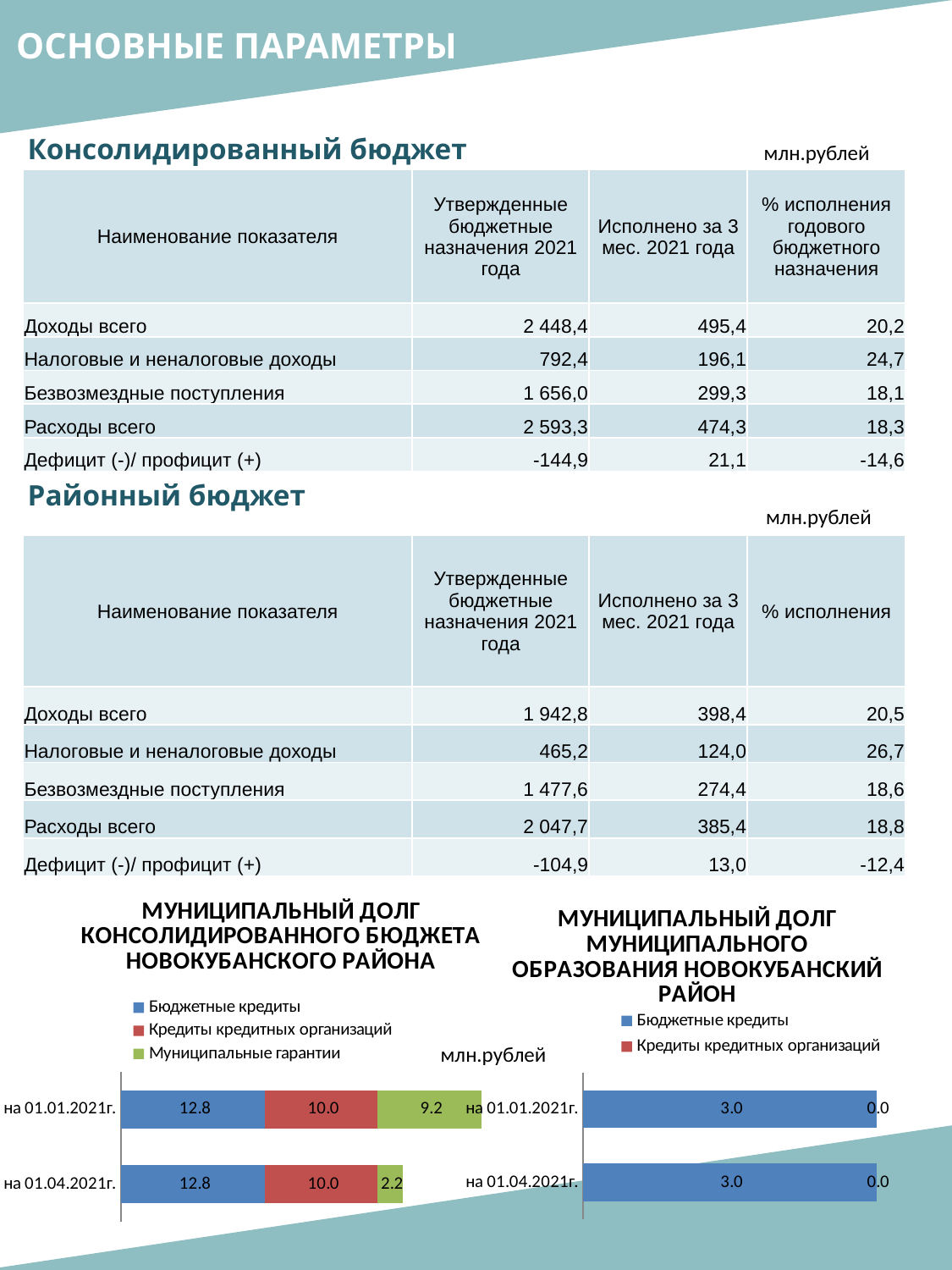
In the chart titled 'МУНИЦИПАЛЬНЫЙ ДОЛГ КОНСОЛИДИРОВАННОГО БЮДЖЕТА НОВОКУБАНСКОГО РАЙОНА', by how much did 'Муниципальные гарантии' decrease from 'на 01.01.2021г.' to 'на 01.04.2021г.'? 7.0 In the chart titled 'МУНИЦИПАЛЬНЫЙ ДОЛГ КОНСОЛИДИРОВАННОГО БЮДЖЕТА НОВОКУБАНСКОГО РАЙОНА', what is the value of 'Кредиты кредитных организаций' for 'на 01.01.2021г.'? 10.0 In the chart titled 'МУНИЦИПАЛЬНЫЙ ДОЛГ КОНСОЛИДИРОВАННОГО БЮДЖЕТА НОВОКУБАНСКОГО РАЙОНА', what is the value of 'Муниципальные гарантии' for 'на 01.01.2021г.'? 9.2 In the chart titled 'МУНИЦИПАЛЬНЫЙ ДОЛГ КОНСОЛИДИРОВАННОГО БЮДЖЕТА НОВОКУБАНСКОГО РАЙОНА', what is the value of 'Муниципальные гарантии' for 'на 01.04.2021г.'? 2.2 What type of chart is the one titled 'МУНИЦИПАЛЬНЫЙ ДОЛГ МУНИЦИПАЛЬНОГО ОБРАЗОВАНИЯ НОВОКУБАНСКИЙ РАЙОН'? Bar chart In the chart titled 'МУНИЦИПАЛЬНЫЙ ДОЛГ КОНСОЛИДИРОВАННОГО БЮДЖЕТА НОВОКУБАНСКОГО РАЙОНА', how many series does the legend list? 3 In the chart titled 'МУНИЦИПАЛЬНЫЙ ДОЛГ КОНСОЛИДИРОВАННОГО БЮДЖЕТА НОВОКУБАНСКОГО РАЙОНА', what is the value of 'Бюджетные кредиты' for 'на 01.04.2021г.'? 12.8 In the chart titled 'МУНИЦИПАЛЬНЫЙ ДОЛГ КОНСОЛИДИРОВАННОГО БЮДЖЕТА НОВОКУБАНСКОГО РАЙОНА', what is the total of the stacked bar for 'на 01.01.2021г.'? 32.0 In the chart titled 'МУНИЦИПАЛЬНЫЙ ДОЛГ КОНСОЛИДИРОВАННОГО БЮДЖЕТА НОВОКУБАНСКОГО РАЙОНА', which series is larger for 'на 01.04.2021г.': 'Бюджетные кредиты' or 'Муниципальные гарантии'? Бюджетные кредиты In the chart titled 'МУНИЦИПАЛЬНЫЙ ДОЛГ КОНСОЛИДИРОВАННОГО БЮДЖЕТА НОВОКУБАНСКОГО РАЙОНА', what is the total of the stacked bar for 'на 01.04.2021г.'? 25.0 In the chart titled 'МУНИЦИПАЛЬНЫЙ ДОЛГ МУНИЦИПАЛЬНОГО ОБРАЗОВАНИЯ НОВОКУБАНСКИЙ РАЙОН', what is the value of 'Кредиты кредитных организаций' for 'на 01.01.2021г.'? 0.0 In the chart titled 'МУНИЦИПАЛЬНЫЙ ДОЛГ МУНИЦИПАЛЬНОГО ОБРАЗОВАНИЯ НОВОКУБАНСКИЙ РАЙОН', what is the value of 'Бюджетные кредиты' for 'на 01.04.2021г.'? 3.0